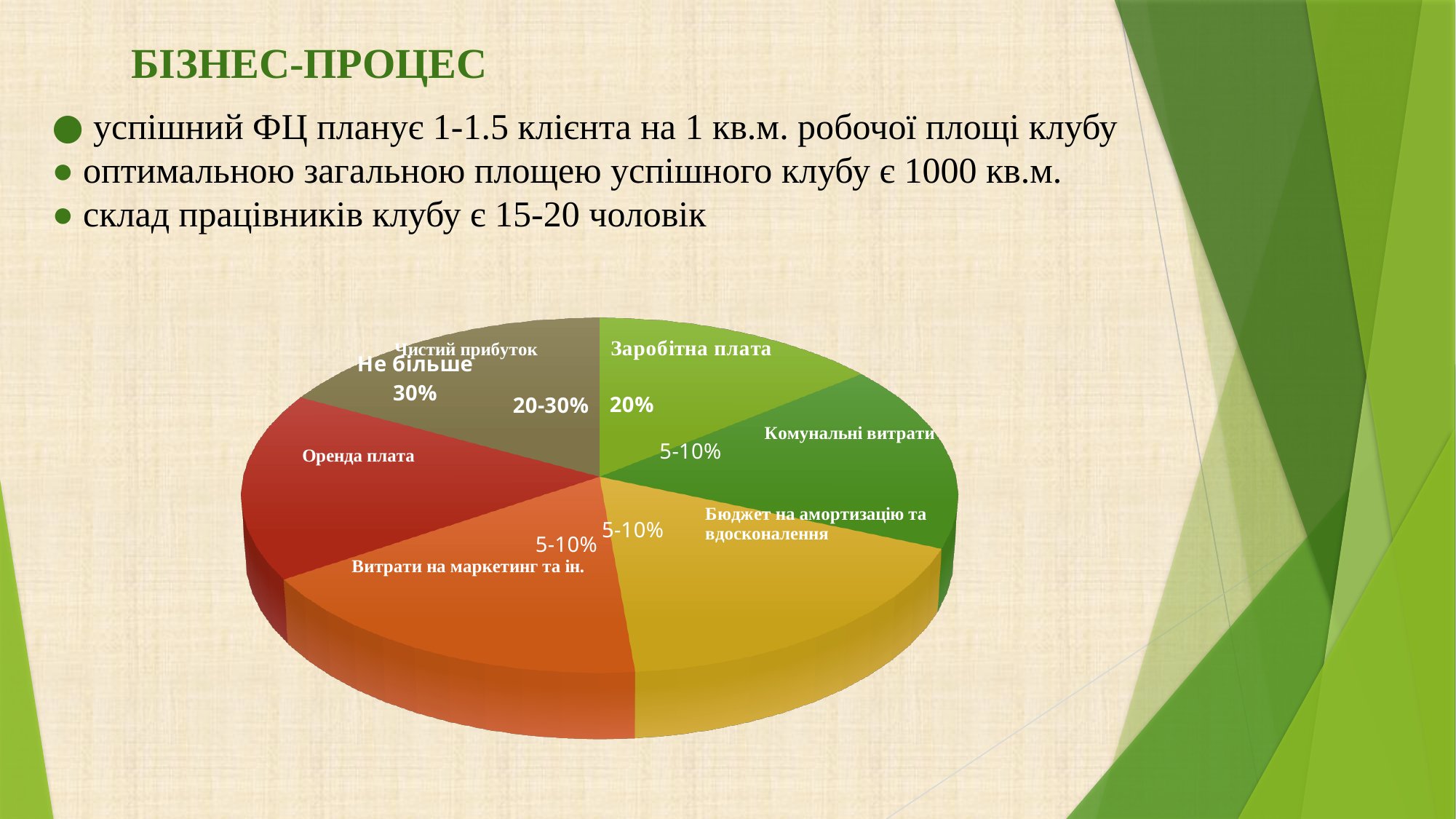
What is the title of the slide containing the pie chart? БІЗНЕС-ПРОЦЕС Which slice of the pie chart is labelled exactly 20%? Заробітна плата What value is shown for the Чистий прибуток slice? 20-30% What value is shown for the Бюджет на амортизацію та вдосконалення slice? 5-10% What kind of chart is shown on the slide? pie chart What value is shown for the Заробітна плата slice? 20% What value is shown for the Витрати на маркетинг та ін. slice? 5-10% How many slices does the pie chart have? 6 What value is shown for the Комунальні витрати slice? 5-10% What value is shown for the Оренда плата slice? Не більше 30% What colour is the Оренда плата slice of the pie chart? dark red How many slices of the pie chart are labelled 5-10%? 3